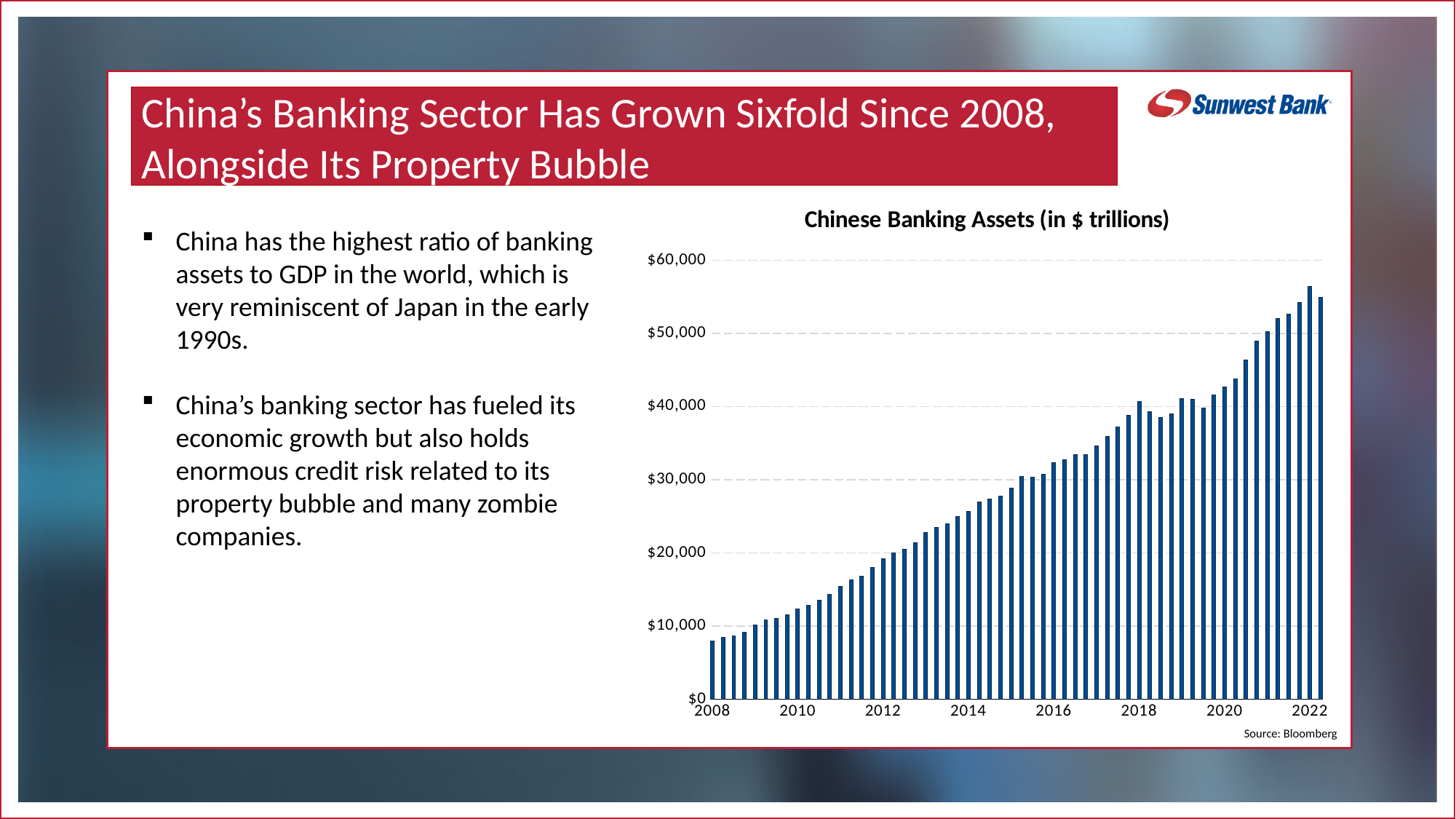
Is the value for the first bar in 2010 greater or less than $10,000? greater Which is larger, the value for 2008 or the value for 2020? 2020 Is the value for the first bar in 2016 greater or less than $30,000? greater Is the value for the first bar in 2014 greater or less than $20,000? greater Which year has the highest bars in the chart? 2022 What is the source cited for the chart? Bloomberg Which year has the lowest bars in the chart? 2008 What kind of chart is shown on the slide? bar chart Do the values in the chart generally rise or fall from 2008 to 2022? rise What is the title of the chart? Chinese Banking Assets (in $ trillions)